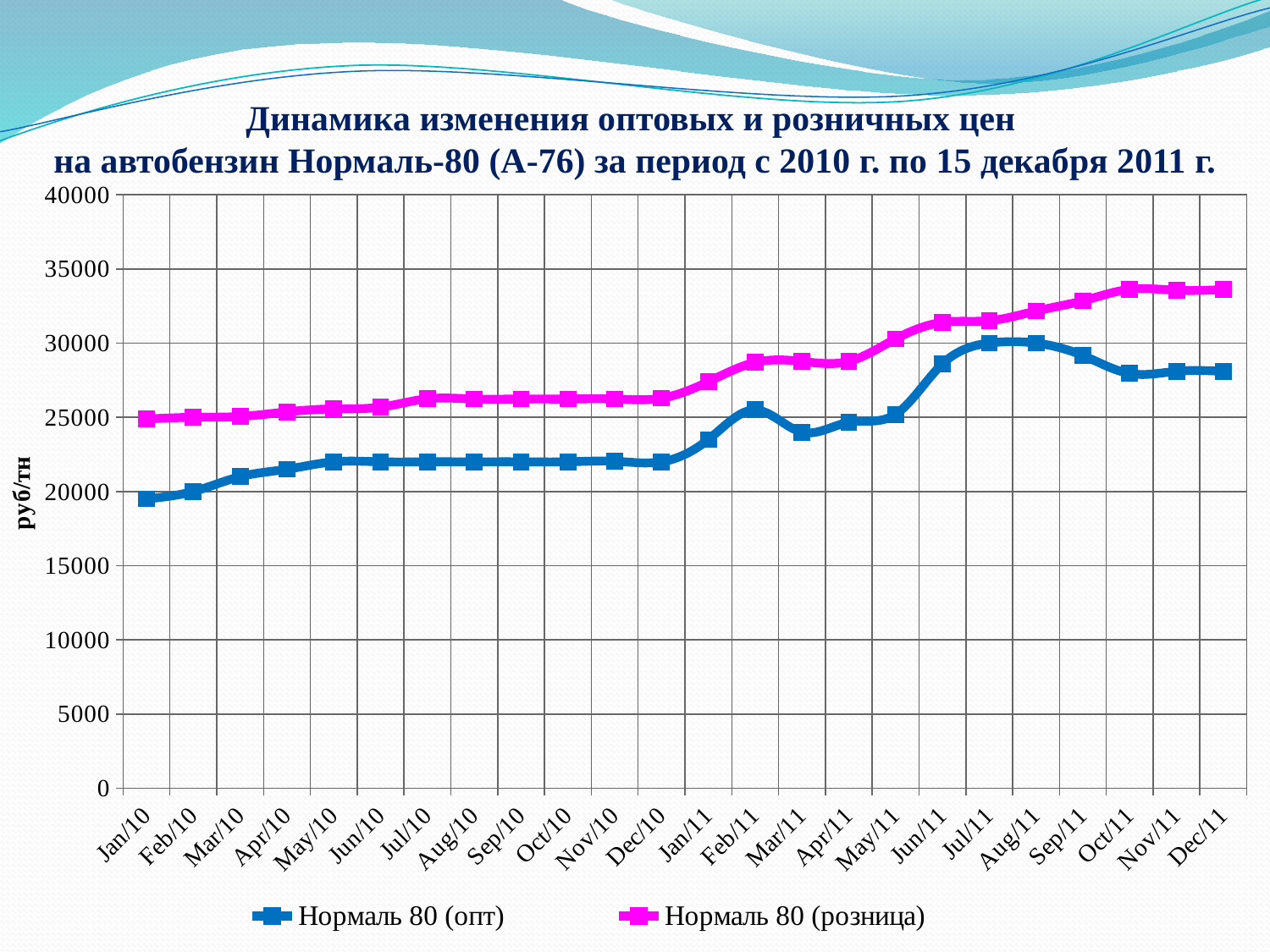
Which series has the higher value in Jun/11, Нормаль 80 (опт) or Нормаль 80 (розница)? Нормаль 80 (розница) Is the value for Нормаль 80 (розница) in Dec/11 greater or less than 30000? greater What kind of chart is shown on the slide? line chart In which month is the Нормаль 80 (опт) series at its lowest? Jan/10 Do the Нормаль 80 (розница) values generally rise or fall from Jan/10 to Dec/11? rise How many series does the legend list? 2 For Нормаль 80 (опт), which is higher: the value in Jan/10 or the value in Dec/11? Dec/11 Is the value for Нормаль 80 (опт) in Jan/10 greater or less than 20000? less Is the value for Нормаль 80 (розница) in Jul/10 greater or less than 25000? greater What unit is shown on the vertical axis label? руб/тн How many months are plotted along the x axis? 24